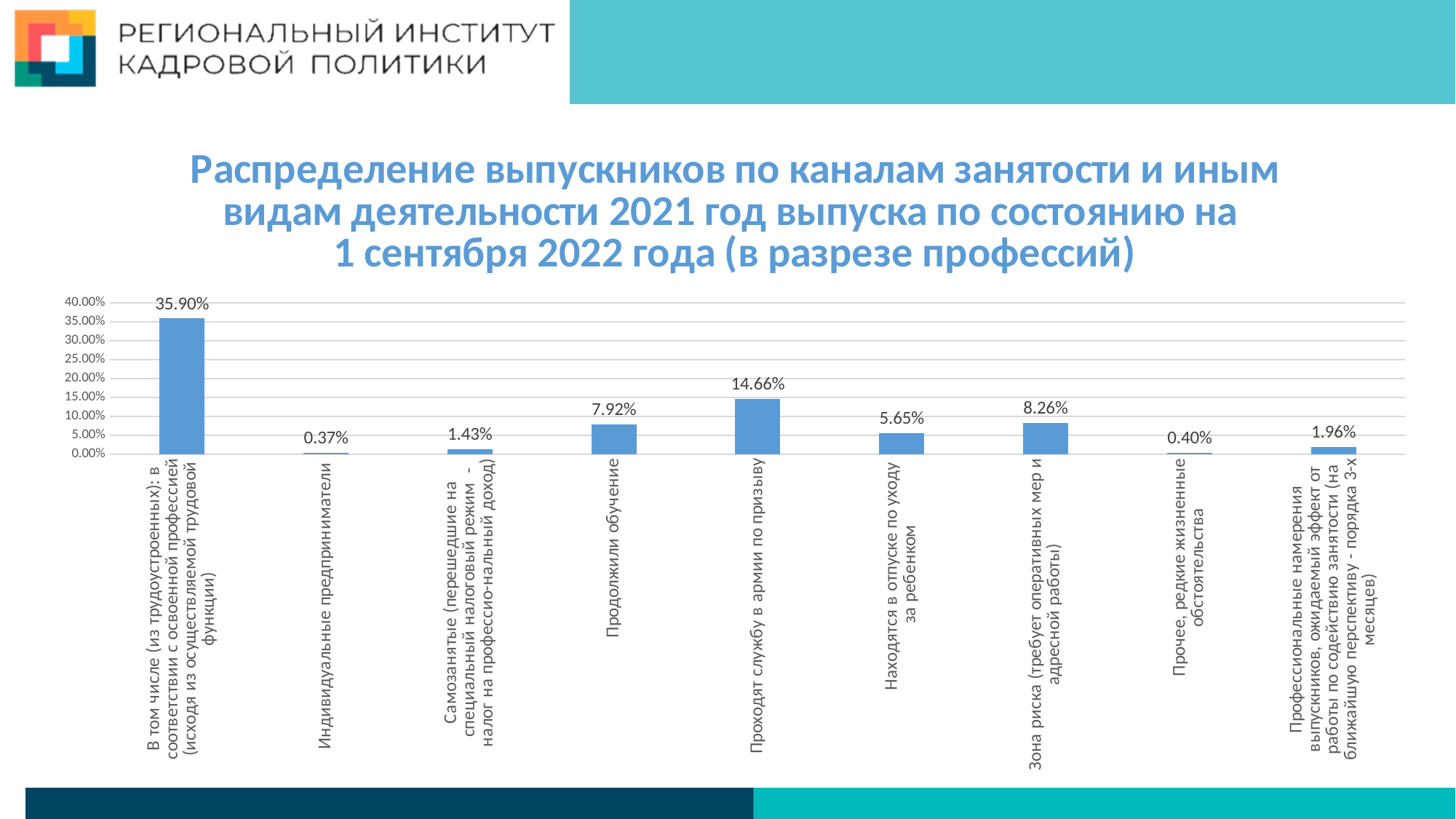
What is the difference between the values for "Зона риска (требует оперативных мер и адресной работы)" and "Находятся в отпуске по уходу за ребенком"? 2.61% What is the value for "Индивидуальные предприниматели"? 0.37% What is the value for "Находятся в отпуске по уходу за ребенком"? 5.65% How many categories are shown on the chart? 9 Which category has the lowest value? Индивидуальные предприниматели What is the value for "Проходят службу в армии по призыву"? 14.66% What is the value for "Продолжили обучение"? 7.92% What is the difference between the values for "Проходят службу в армии по призыву" and "Продолжили обучение"? 6.74% What type of chart is shown on the slide? bar chart Is the value for "Самозанятые (перешедшие на специальный налоговый режим - налог на профессиональный доход)" greater or less than 5.00%? less Which category has the highest value? В том числе (из трудоустроенных): в соответствии с освоенной профессией (исходя из осуществляемой трудовой функции) Which is larger: the value for "Зона риска (требует оперативных мер и адресной работы)" or the value for "Продолжили обучение"? Зона риска (требует оперативных мер и адресной работы)